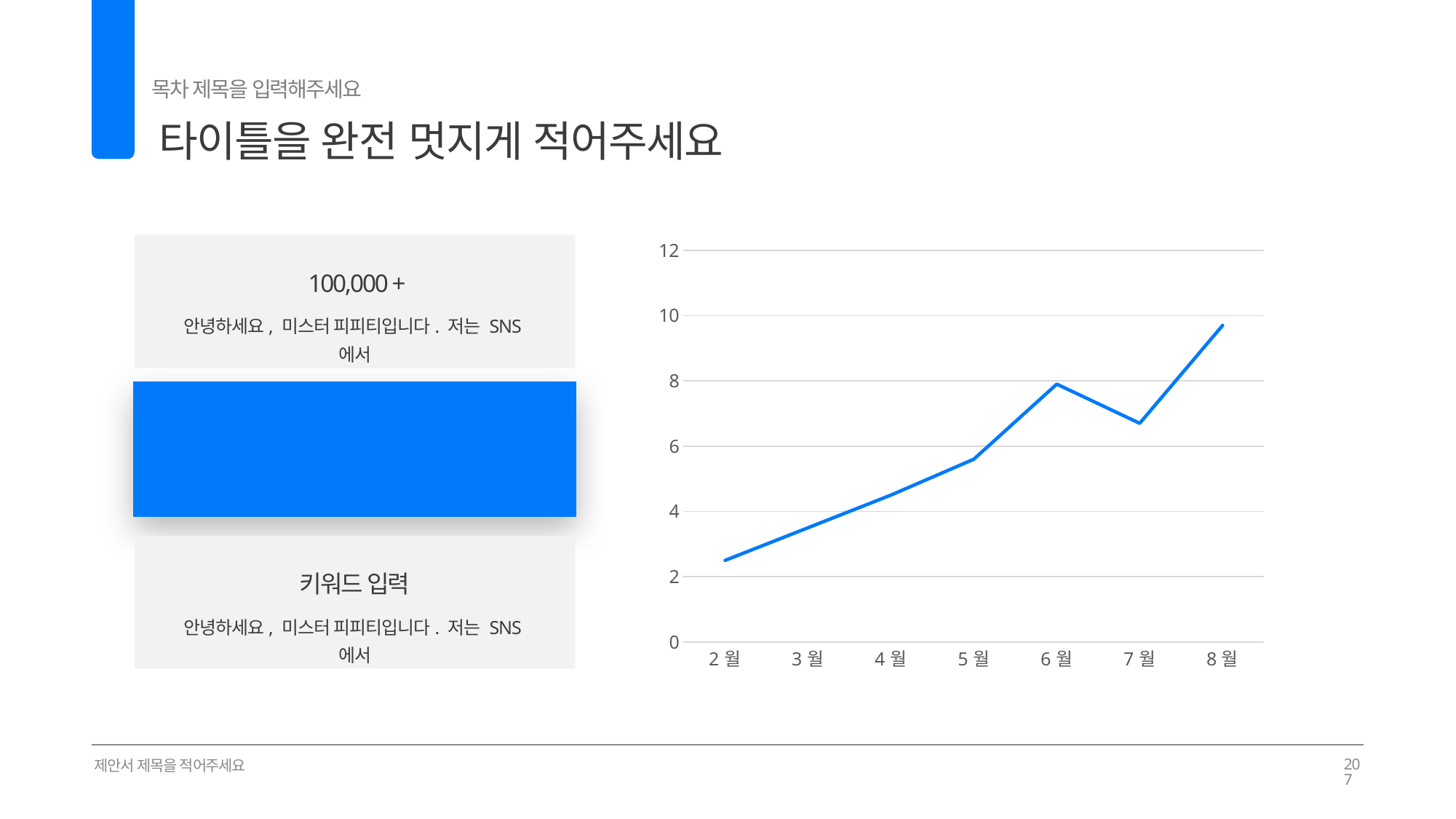
Which month has the lowest value in the line chart? 2월 Does the line rise or fall from 2월 to 6월? rise What kind of chart is shown on the slide? line chart Is the value for 8월 greater or less than 8? greater Is the value for 7월 greater or less than 8? less Is the value for 6월 greater or less than 6? greater Which is larger, the value for 6월 or the value for 7월? 6월 Which is larger, the value for 3월 or the value for 5월? 5월 Which month has the highest value in the line chart? 8월 How many months are plotted along the x axis of the line chart? 7 What is the highest value shown on the y axis of the line chart? 12